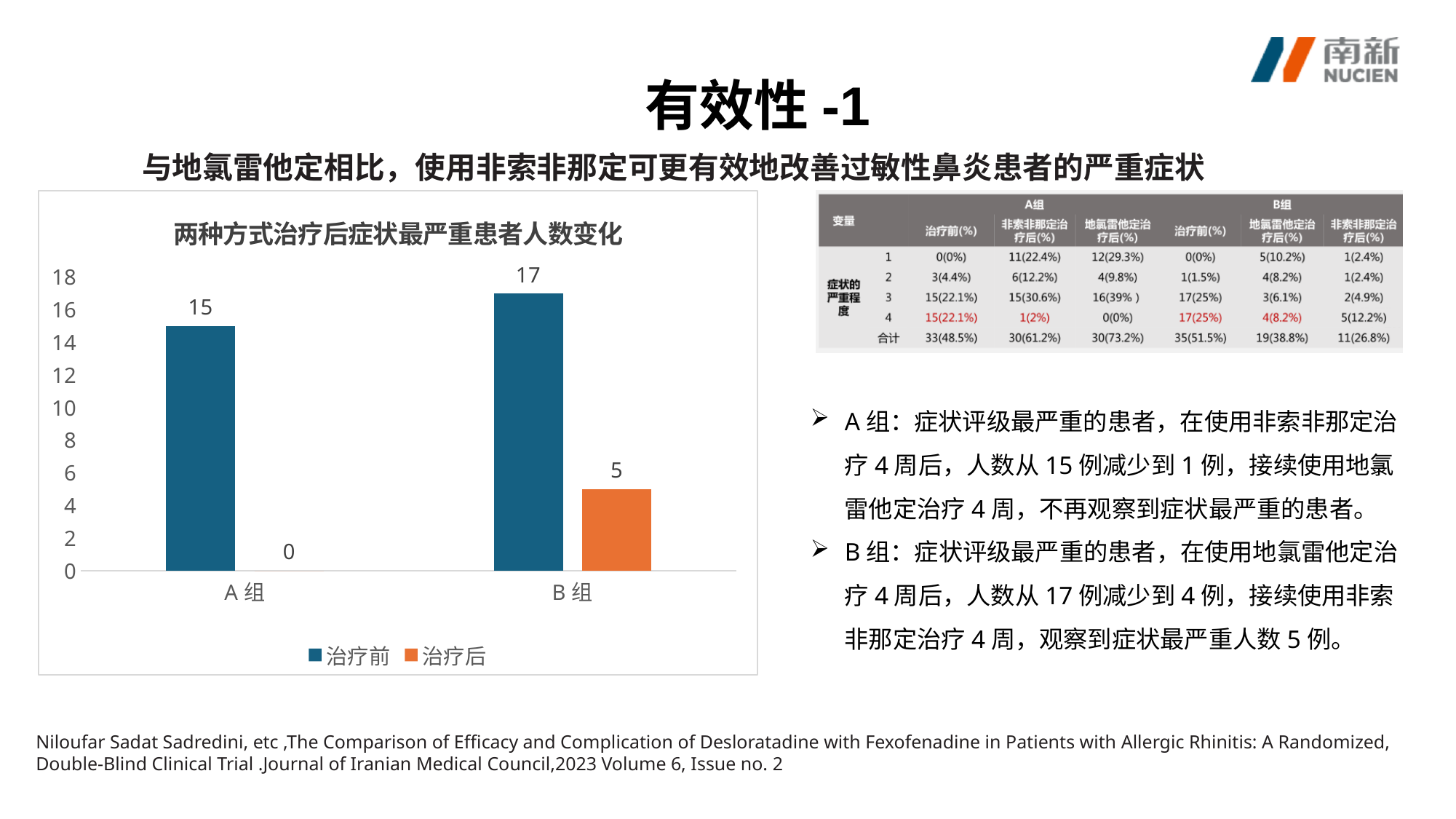
What is the difference between the 治疗前 values for B 组 and A 组? 2 What is the value for 治疗后 in A 组? 0 Which category has the highest 治疗前 value? B 组 How many categories are shown on the x axis? 2 Which is larger, the 治疗后 value for A 组 or for B 组? B 组 What is the value for 治疗前 in B 组? 17 What is the value for 治疗后 in B 组? 5 What is the value for 治疗前 in A 组? 15 What is the difference between the 治疗前 and 治疗后 values for B 组? 12 Which category has the lowest 治疗后 value? A 组 What kind of chart is shown on the slide? Bar chart How many series does the legend list? 2